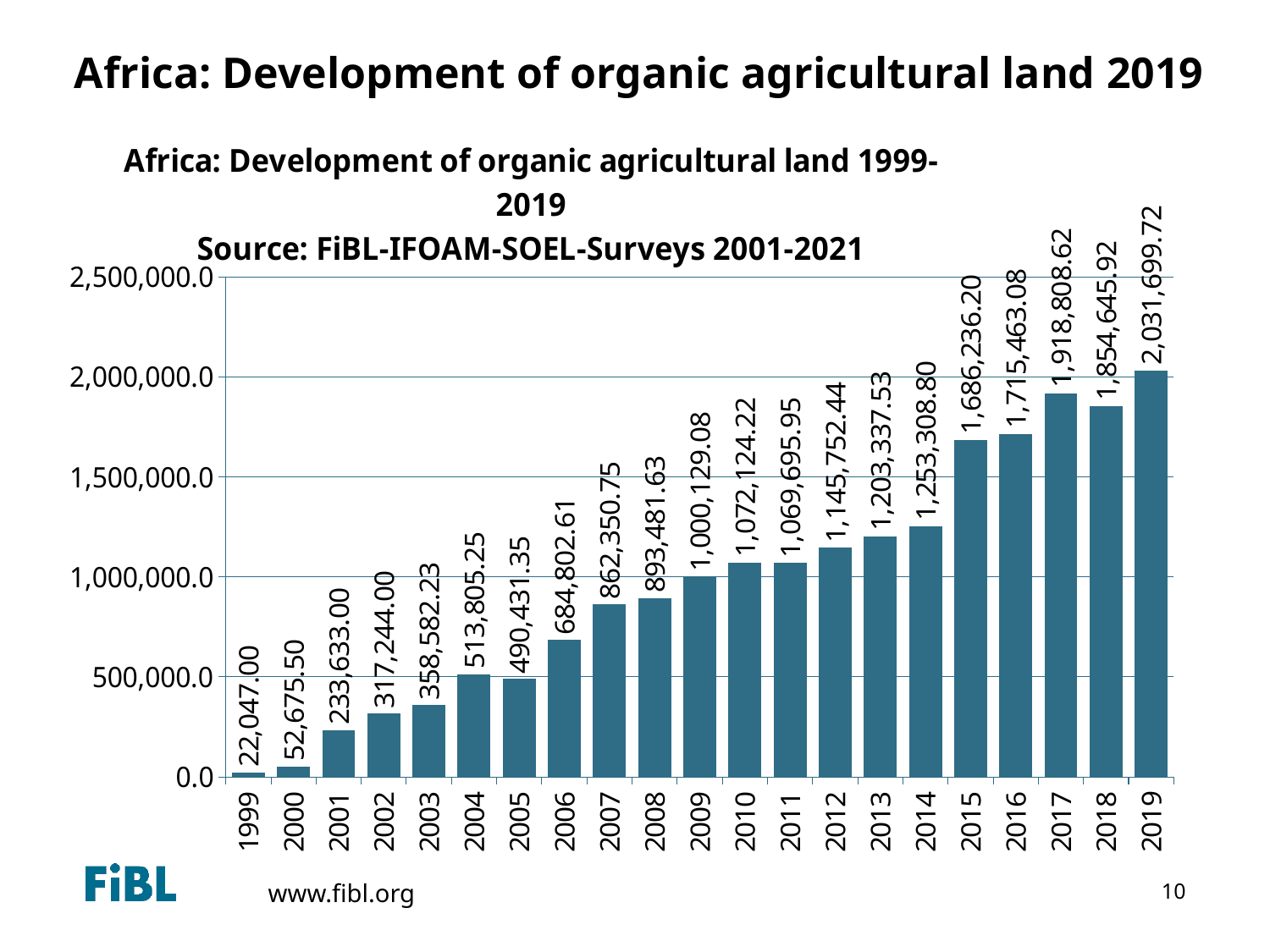
What is the value for 2015? 1,686,236.20 What is the difference between the values for 2019 and 2018? 177,053.80 Is the value for 2014 greater or less than 1,500,000.0? less What is the value for 2009? 1,000,129.08 What is the source given in the chart title? FiBL-IFOAM-SOEL-Surveys 2001-2021 What is the value for 1999? 22,047.00 Which year has the lowest value? 1999 How many years are shown on the x axis? 21 What is the value for 2019? 2,031,699.72 What kind of chart is shown? bar chart Which year has the highest value? 2019 Which is larger, the value for 2017 or the value for 2018? 2017